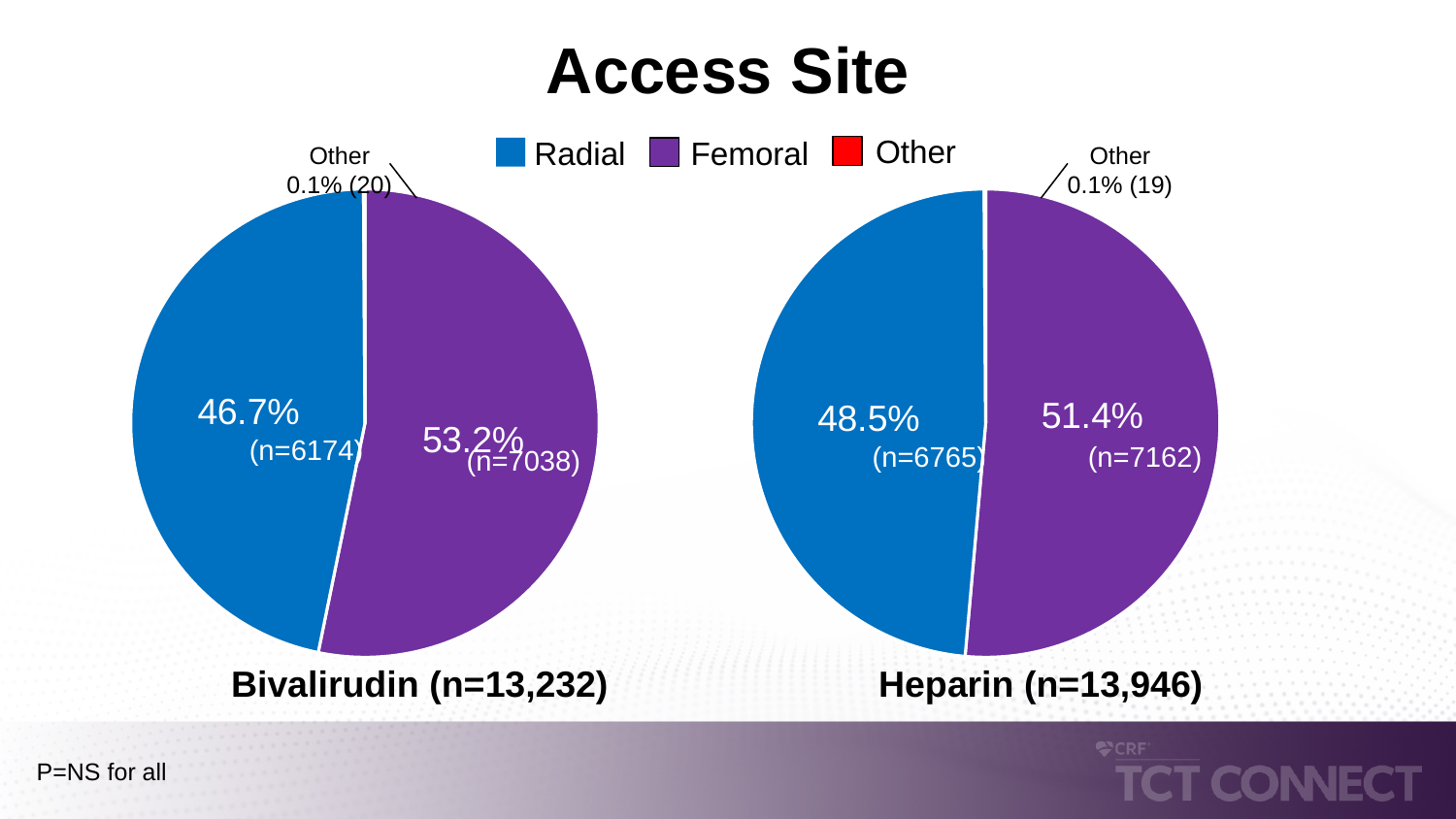
How many series does the legend list? 3 In the Heparin pie chart, what percentage of patients had femoral access? 51.4% In the Heparin pie chart, how many patients had femoral access (n)? n=7162 Which chart shows a higher radial access percentage, Bivalirudin or Heparin? Heparin What type of charts are shown on the slide? Pie charts In the Bivalirudin pie chart, what percentage of patients had femoral access? 53.2% In the Bivalirudin pie chart, which access site has the largest share? Femoral In the Bivalirudin pie chart, what percentage of patients had radial access? 46.7% In the Heparin pie chart, what is the difference in percentage points between femoral and radial access? 2.9 percentage points In the Heparin pie chart, what percentage of patients had radial access? 48.5% In the Heparin pie chart, which access site has the smallest share? Other In the Bivalirudin pie chart, how many patients had 'Other' access? 20